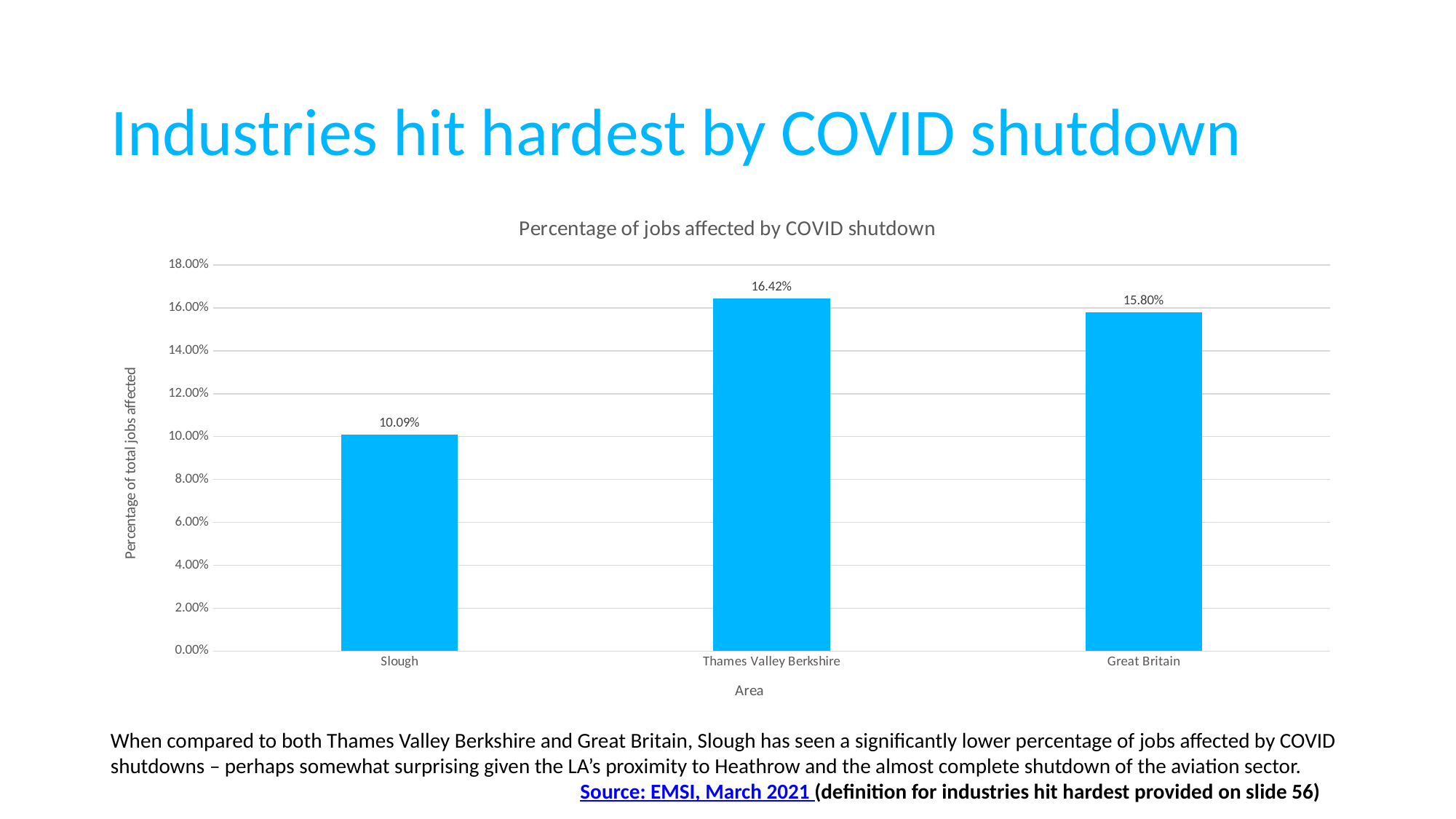
Which has a higher percentage of jobs affected: Slough or Great Britain? Great Britain Which area has the highest percentage of jobs affected by COVID shutdown? Thames Valley Berkshire Which area has the lowest percentage of jobs affected by COVID shutdown? Slough What type of chart is shown on the slide? Bar chart Is the value for Slough greater or less than 12.00%? less What is the difference in percentage points between Thames Valley Berkshire and Slough? 6.33% What is the difference in percentage points between Thames Valley Berkshire and Great Britain? 0.62% What is the percentage of jobs affected by COVID shutdown for Great Britain? 15.80% What is the percentage of jobs affected by COVID shutdown for Slough? 10.09% How many areas are shown on the chart? 3 What is the percentage of jobs affected by COVID shutdown for Thames Valley Berkshire? 16.42% What is the title of the chart? Percentage of jobs affected by COVID shutdown